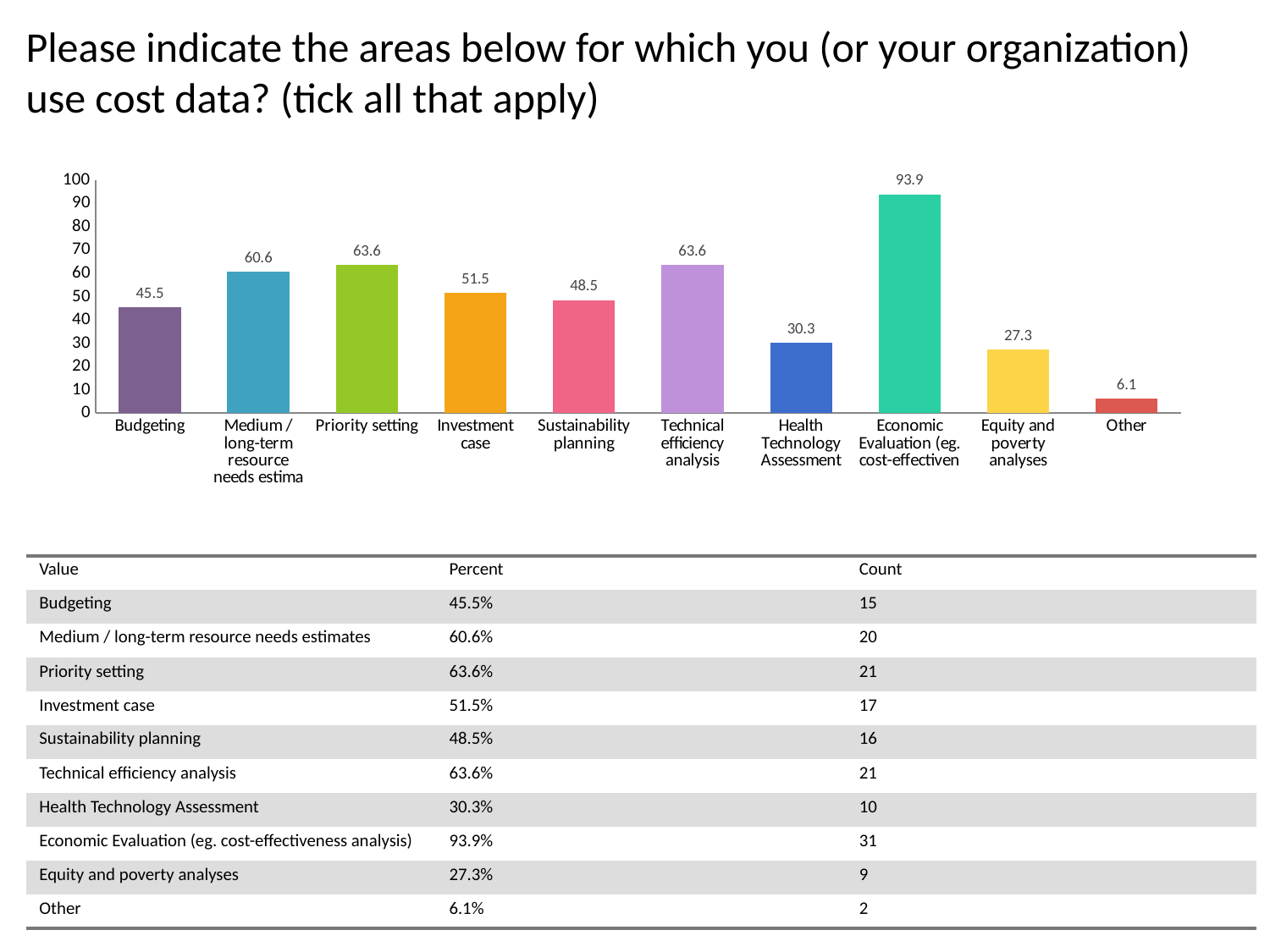
What is the value for Budgeting? 45.5 What is the value for Health Technology Assessment? 30.3 What is the difference between the values for Priority setting and Sustainability planning? 15.1 What kind of chart is shown on the slide? bar chart Which is larger, the value for Budgeting or the value for Investment case? Investment case Which category has the highest value? Economic Evaluation (eg. cost-effectiven How many categories are shown in the chart? 10 What is the maximum value shown on the vertical axis? 100 What is the difference between the values for Economic Evaluation and Other? 87.8 Is the value for Equity and poverty analyses greater or less than 30? less Which category has the lowest value? Other What is the value for Investment case? 51.5